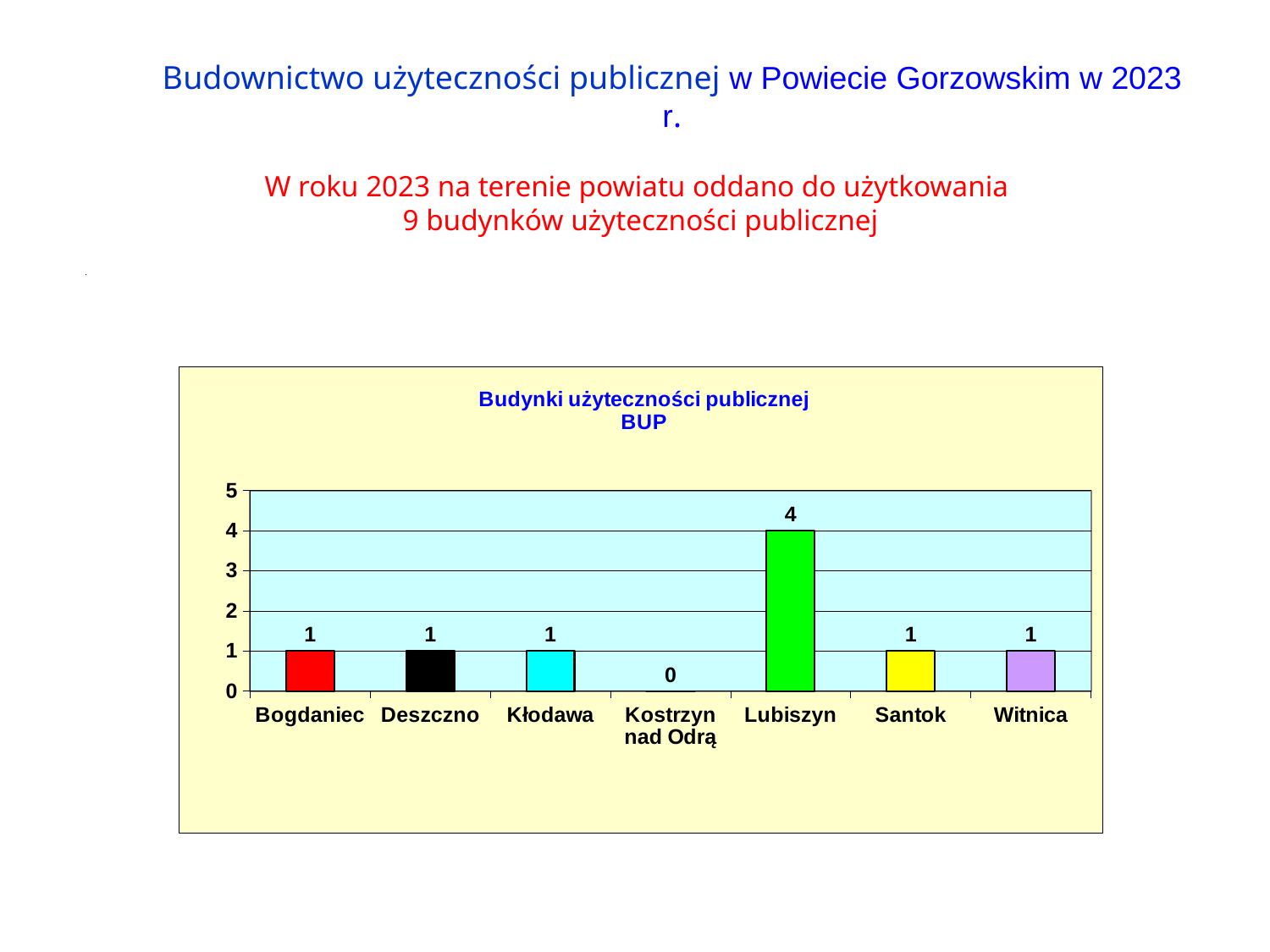
Which is larger, the value for Lubiszyn or the value for Witnica? Lubiszyn What colour is the bar for Lubiszyn? green Which category has the highest value? Lubiszyn What kind of chart is shown? bar chart Which category has the lowest value? Kostrzyn nad Odrą What is the title of the chart? Budynki użyteczności publicznej BUP Is the value for Lubiszyn greater or less than 3? greater What is the value for Kostrzyn nad Odrą? 0 What is the value for Santok? 1 What is the value for Lubiszyn? 4 How many categories are shown on the x axis? 7 What is the difference between the values for Lubiszyn and Bogdaniec? 3